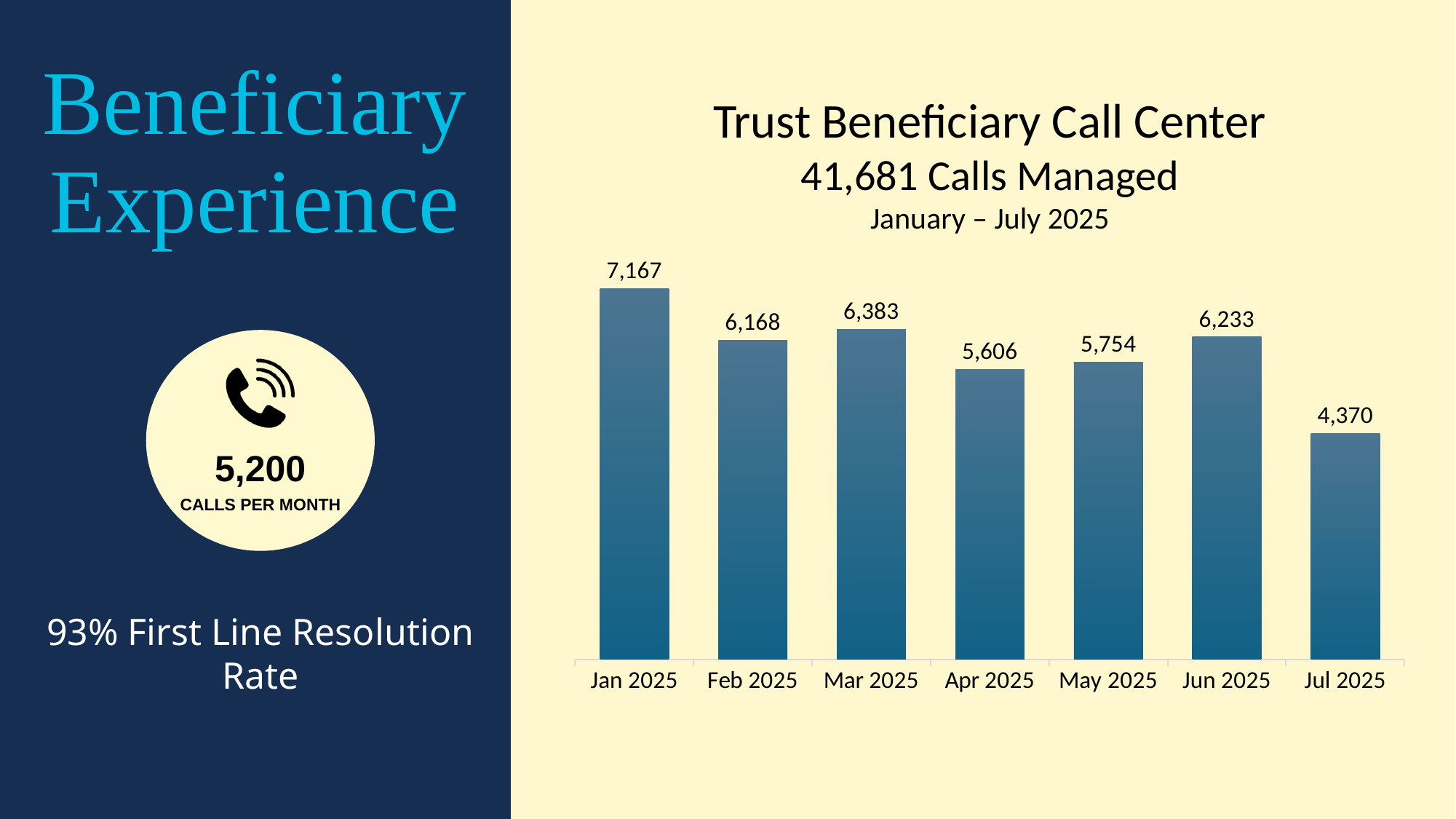
What is the value for Jul 2025? 4,370 Do the values generally rise or fall from Jan 2025 to Jul 2025? Fall What is the difference between the values for Mar 2025 and Feb 2025? 215 Which is larger, the value for Jun 2025 or the value for May 2025? Jun 2025 What is the value for Jan 2025? 7,167 What is the value for Apr 2025? 5,606 How many months are shown on the chart? 7 Which month has the highest number of calls? Jan 2025 What is the difference between the values for Jan 2025 and Jul 2025? 2,797 What is the title of the chart? Trust Beneficiary Call Center Which month has the lowest number of calls? Jul 2025 What kind of chart is shown on the slide? Bar chart